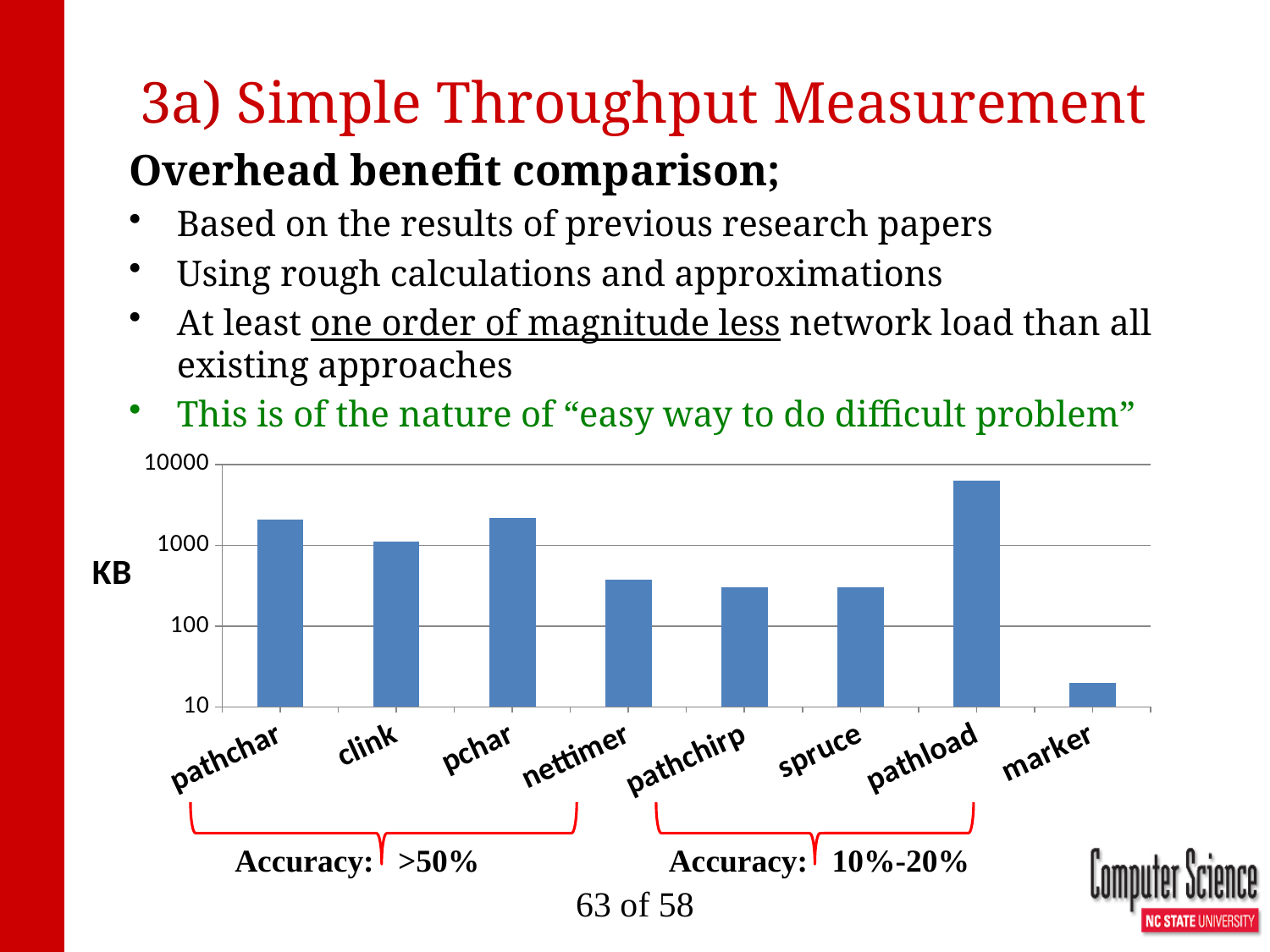
Is the value for nettimer greater or less than 100? greater Is the value for marker greater or less than 100? less Is the value for pathchirp greater or less than 1000? less What kind of chart is shown on the slide? bar chart How many categories (tools) are shown on the x axis of the chart? 8 What unit is shown as the label on the y axis of the chart? KB Which has a larger value, clink or nettimer? clink Which tool has the highest value in the chart? pathload Which has a larger value, pathload or pathchar? pathload Which tool has the lowest value in the chart? marker